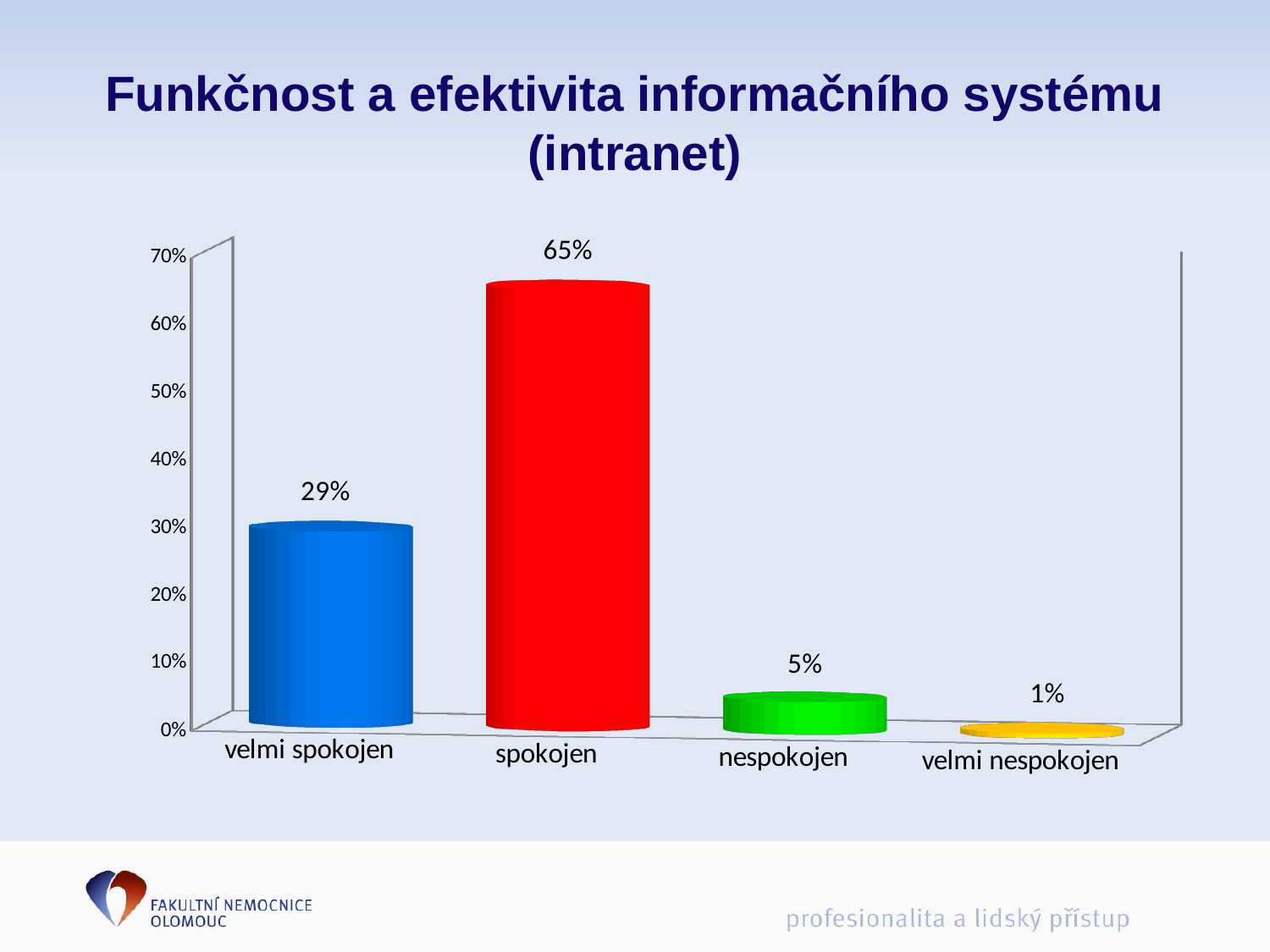
What is the value for "nespokojen"? 5% What is the value for "velmi spokojen"? 29% Which is larger, the value for "velmi spokojen" or the value for "nespokojen"? velmi spokojen How many categories are shown on the chart? 4 What is the value for "velmi nespokojen"? 1% Which category has the lowest value? velmi nespokojen Which category has the highest value? spokojen What kind of chart is shown on the slide? bar chart What is the value for "spokojen"? 65% What is the title of the slide? Funkčnost a efektivita informačního systému (intranet) What is the difference between the values for "spokojen" and "velmi spokojen"? 36% Is the value for "spokojen" greater or less than 60%? greater